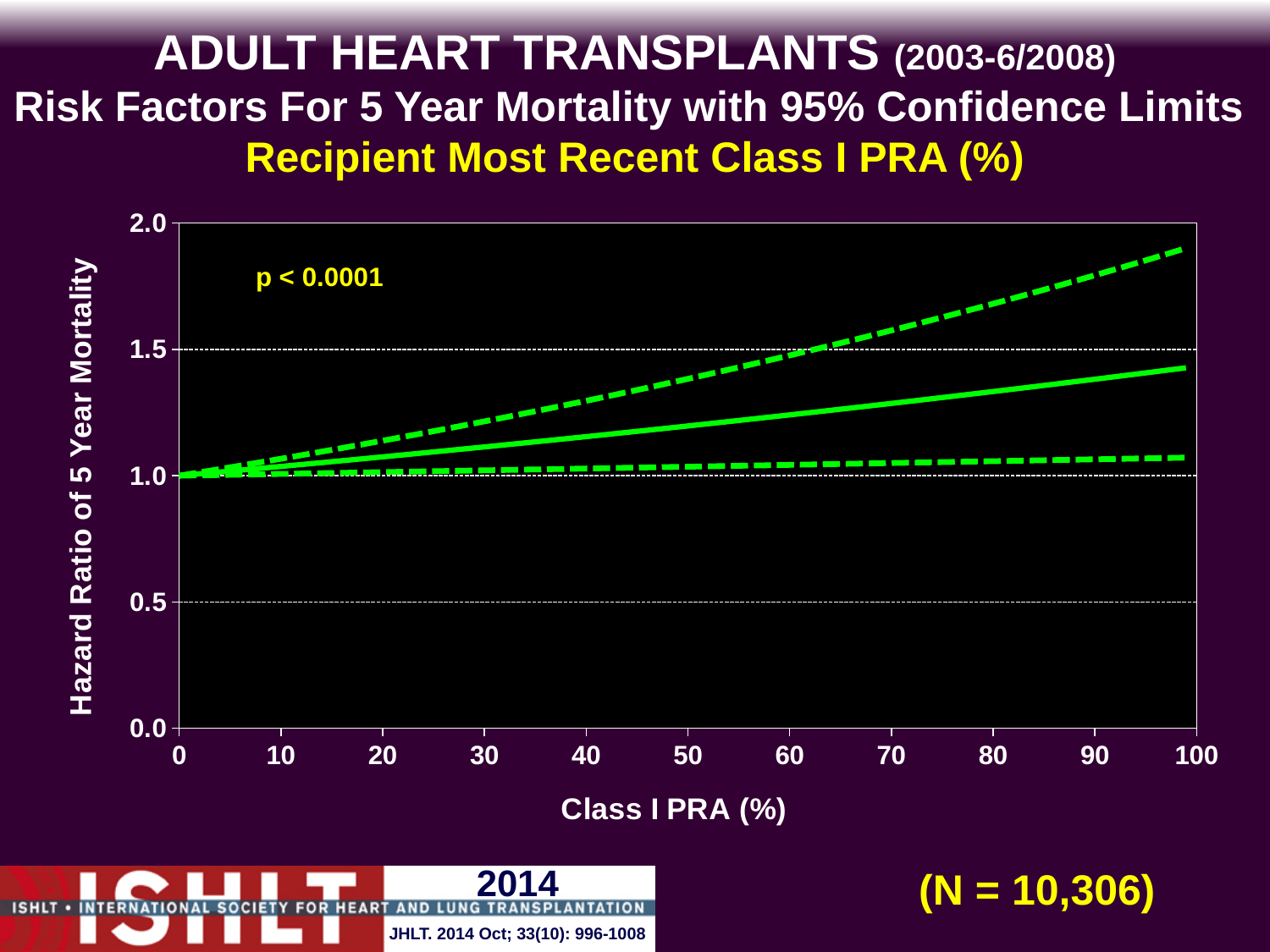
What kind of chart is shown on the slide? line chart What is the label of the x axis? Class I PRA (%) Is the upper dashed confidence limit at a Class I PRA of 100 greater or less than 1.5? greater At a Class I PRA of 100, which is larger: the solid line or the lower dashed confidence limit? the solid line Does the solid line (hazard ratio) rise or fall as Class I PRA increases from 0 to 100? rise Is the hazard ratio on the solid line at a Class I PRA of 100 greater or less than 1.0? greater What is the label of the y axis? Hazard Ratio of 5 Year Mortality Is the lower dashed confidence limit at a Class I PRA of 50 greater or less than 1.5? less How many lines are plotted on the chart? 3 Does the upper dashed confidence limit rise or fall as Class I PRA increases? rise